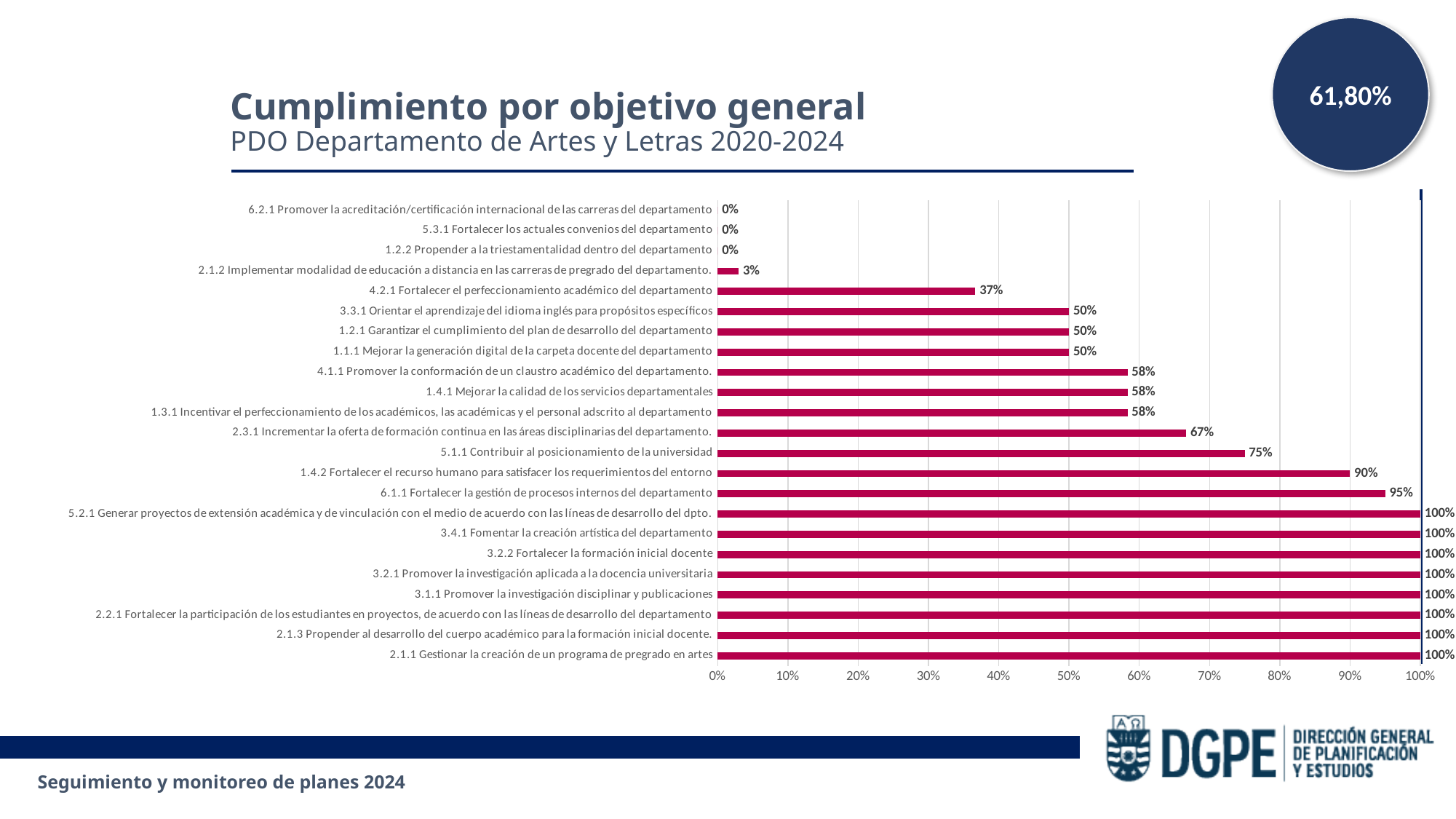
What is the title of the chart on the slide? Cumplimiento por objetivo general Which has a larger value: 4.1.1 Promover la conformación de un claustro académico del departamento or 3.3.1 Orientar el aprendizaje del idioma inglés para propósitos específicos? 4.1.1 Promover la conformación de un claustro académico del departamento What is the value for 4.2.1 Fortalecer el perfeccionamiento académico del departamento? 37% What is the value for 2.1.2 Implementar modalidad de educación a distancia en las carreras de pregrado del departamento? 3% What is the value for 2.3.1 Incrementar la oferta de formación continua en las áreas disciplinarias del departamento? 67% Is the value for 4.2.1 Fortalecer el perfeccionamiento académico del departamento greater or less than 40%? less What is the value for 1.4.2 Fortalecer el recurso humano para satisfacer los requerimientos del entorno? 90% How many objectives are plotted in the chart? 23 How many objectives have a value of 100%? 8 What is the difference between the values for 6.1.1 Fortalecer la gestión de procesos internos del departamento and 1.4.2 Fortalecer el recurso humano para satisfacer los requerimientos del entorno? 5% What kind of chart is shown on the slide? bar chart What is the value for 5.1.1 Contribuir al posicionamiento de la universidad? 75%